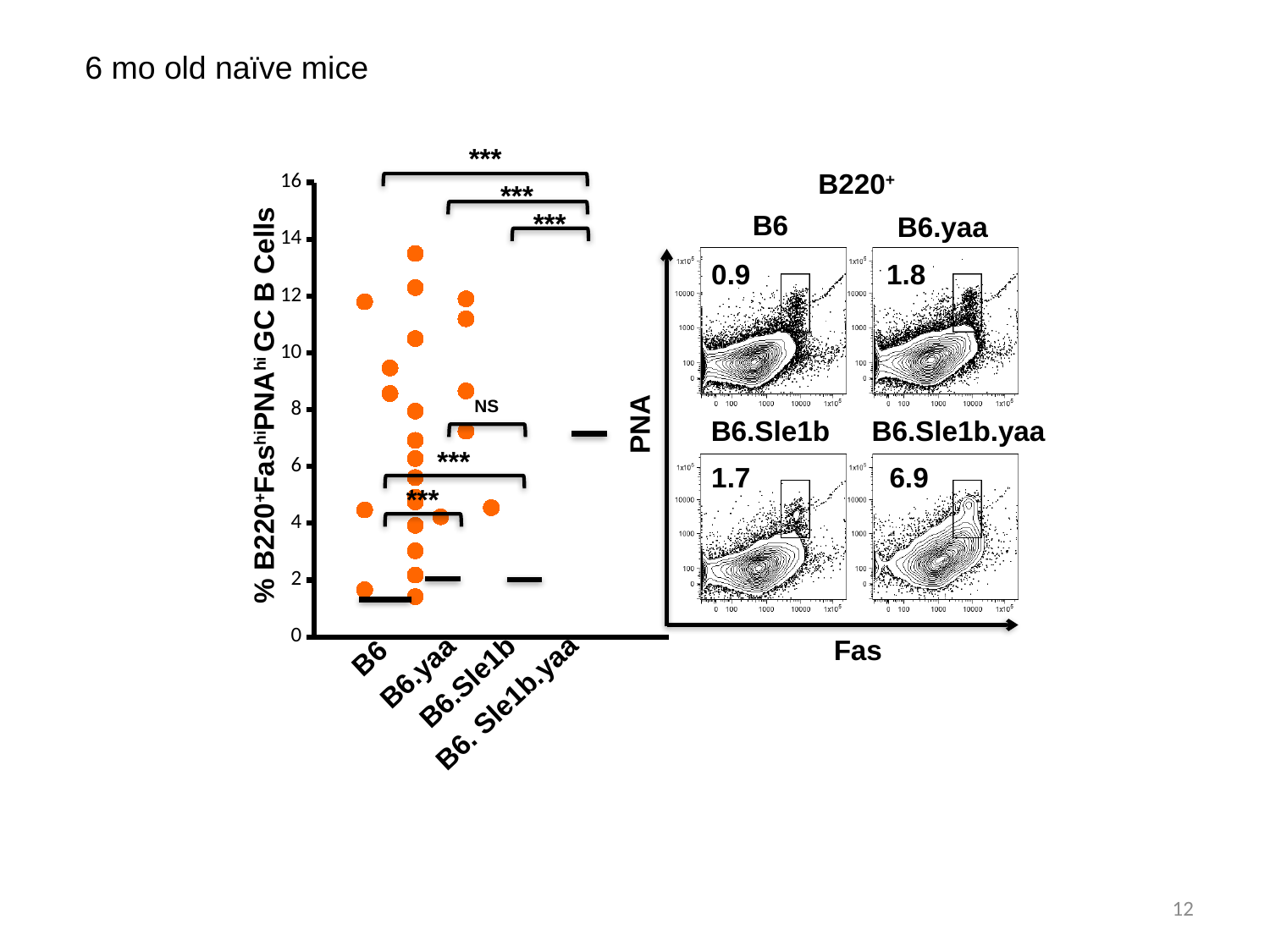
Among the four flow cytometry panels on the right, which strain has the lowest printed percentage? B6 In the flow cytometry panels on the right, what percentage is printed in the B6.Sle1b plot? 1.7 In the dot plot on the left, is the median bar for B6.Sle1b.yaa greater or less than 6? greater In the flow cytometry panels on the right, what percentage is printed in the B6 plot? 0.9 In the flow cytometry panels on the right, what percentage is printed in the B6.Sle1b.yaa plot? 6.9 In the flow cytometry panels on the right, what is the difference between the printed percentages for B6.Sle1b.yaa and B6? 6.0 In the flow cytometry panels on the right, which has the larger printed percentage, B6.yaa or B6.Sle1b? B6.yaa Among the four flow cytometry panels on the right, which strain has the highest printed percentage? B6.Sle1b.yaa How many mouse strains are shown on the x axis of the dot plot on the left? 4 What kind of chart is the plot on the left of the slide? Dot plot (scatter plot) In the dot plot on the left, what significance label is shown on the bracket between B6.yaa and B6.Sle1b? NS In the flow cytometry panels on the right, what percentage is printed in the B6.yaa plot? 1.8